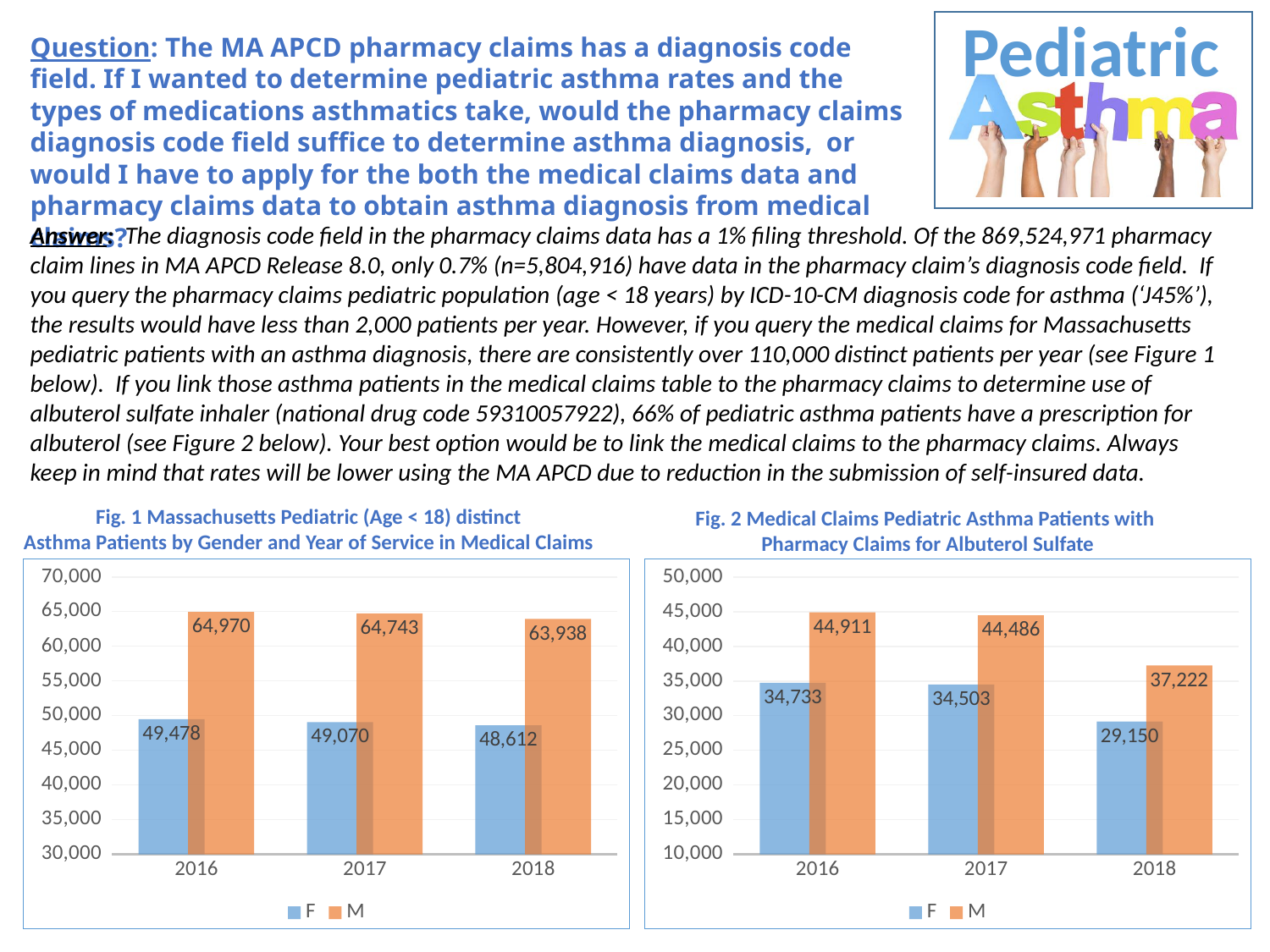
In Fig. 2, which year has the lowest value for F? 2018 In Fig. 1, how many series does the legend list? 2 What kind of chart is Fig. 2? bar chart In Fig. 2, how many years are shown on the x axis? 3 In Fig. 2, what is the value for F in 2018? 29,150 In Fig. 1, what is the value for M in 2018? 63,938 In Fig. 1, what is the difference between M and F in 2017? 15,673 In Fig. 2, what is the difference between M and F in 2018? 8,072 In Fig. 1, what is the value for F in 2016? 49,478 In Fig. 1, which year has the highest value for M? 2016 In Fig. 2, what is the value for M in 2016? 44,911 In Fig. 1, do the values for F rise or fall from 2016 to 2018? fall